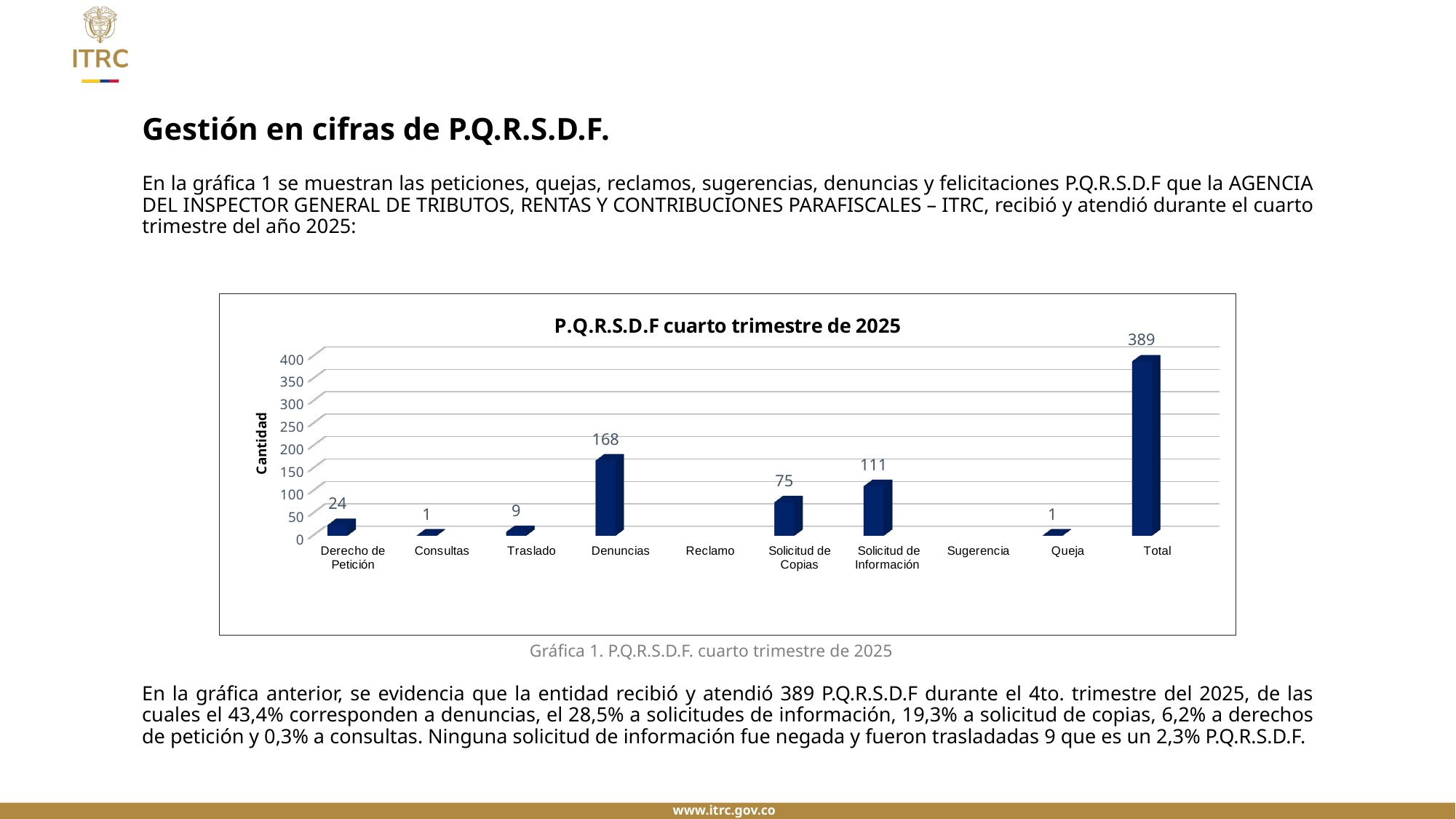
What is the value for Derecho de Petición? 24 Excluding the Total bar, which category has the highest value? Denuncias What is the value for Denuncias in the chart? 168 What is the label of the vertical axis? Cantidad What is the value shown for Total? 389 What is the title of the chart? P.Q.R.S.D.F cuarto trimestre de 2025 What kind of chart is shown on the slide? bar chart How many categories are shown on the x axis? 10 What is the difference between Denuncias and Solicitud de Información? 57 Is the value for Solicitud de Copias greater or less than 100? less What is the value for Solicitud de Información? 111 Which is larger, Solicitud de Copias or Solicitud de Información? Solicitud de Información